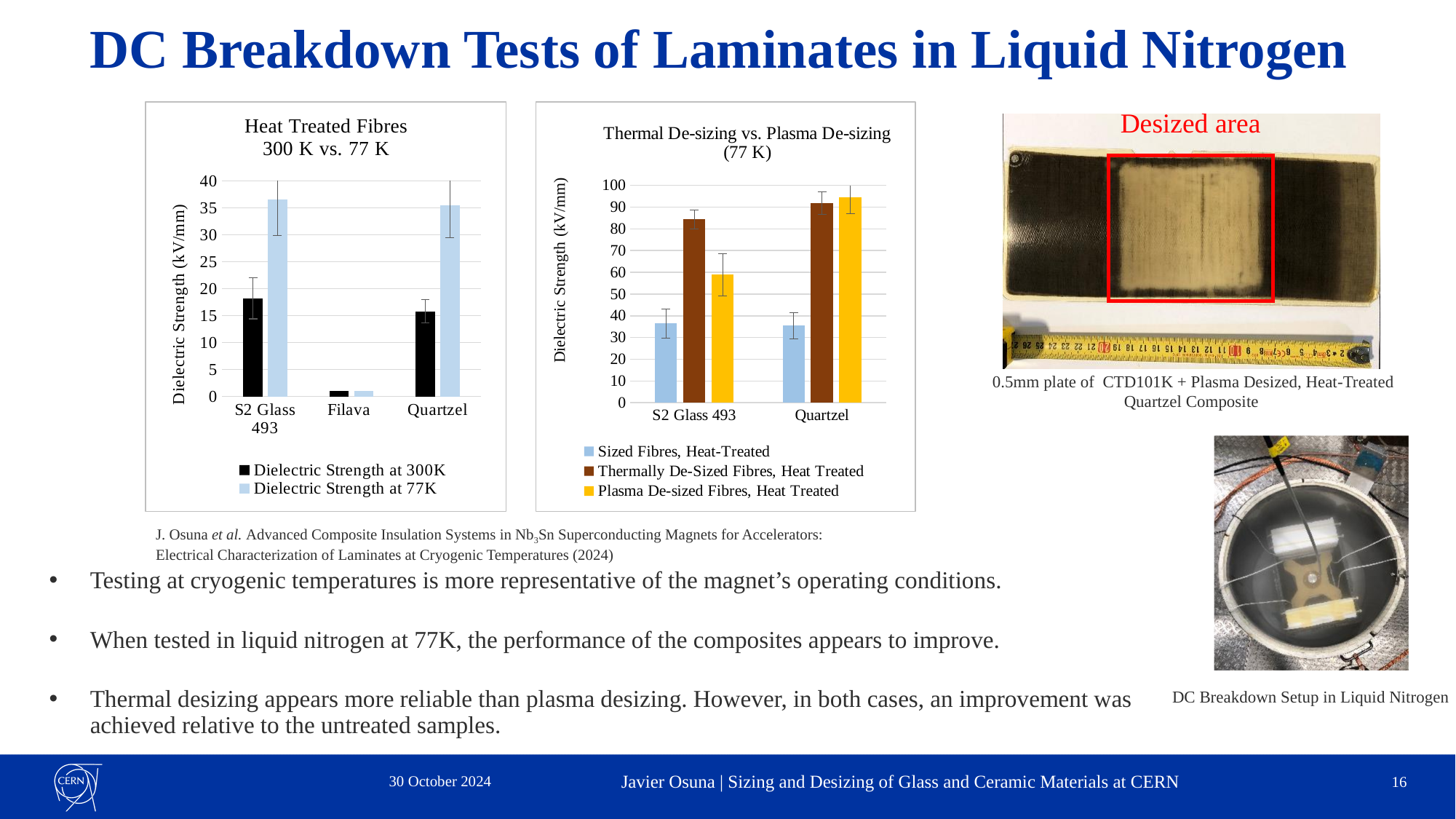
In the 'Thermal De-sizing vs. Plasma De-sizing (77 K)' chart, how many series does the legend list? 3 In the 'Heat Treated Fibres 300 K vs. 77 K' chart, what kind of chart is shown? Bar chart In the 'Heat Treated Fibres 300 K vs. 77 K' chart, is the Dielectric Strength at 77K for S2 Glass 493 greater or less than 30? greater In the 'Heat Treated Fibres 300 K vs. 77 K' chart, which category has the lowest Dielectric Strength at 77K? Filava In the 'Thermal De-sizing vs. Plasma De-sizing (77 K)' chart, which series has the highest value for S2 Glass 493? Thermally De-Sized Fibres, Heat Treated In the 'Heat Treated Fibres 300 K vs. 77 K' chart, for S2 Glass 493, which is larger: Dielectric Strength at 300K or at 77K? Dielectric Strength at 77K In the 'Heat Treated Fibres 300 K vs. 77 K' chart, how many series does the legend list? 2 In the 'Heat Treated Fibres 300 K vs. 77 K' chart, how many fibre categories are shown on the x axis? 3 In the 'Thermal De-sizing vs. Plasma De-sizing (77 K)' chart, is the value for Plasma De-sized Fibres, Heat Treated for S2 Glass 493 greater or less than 50? greater In the 'Thermal De-sizing vs. Plasma De-sizing (77 K)' chart, what is the label of the y axis? Dielectric Strength (kV/mm) In the 'Thermal De-sizing vs. Plasma De-sizing (77 K)' chart, how many categories are shown on the x axis? 2 In the 'Heat Treated Fibres 300 K vs. 77 K' chart, is the Dielectric Strength at 300K for Filava greater or less than 5? less